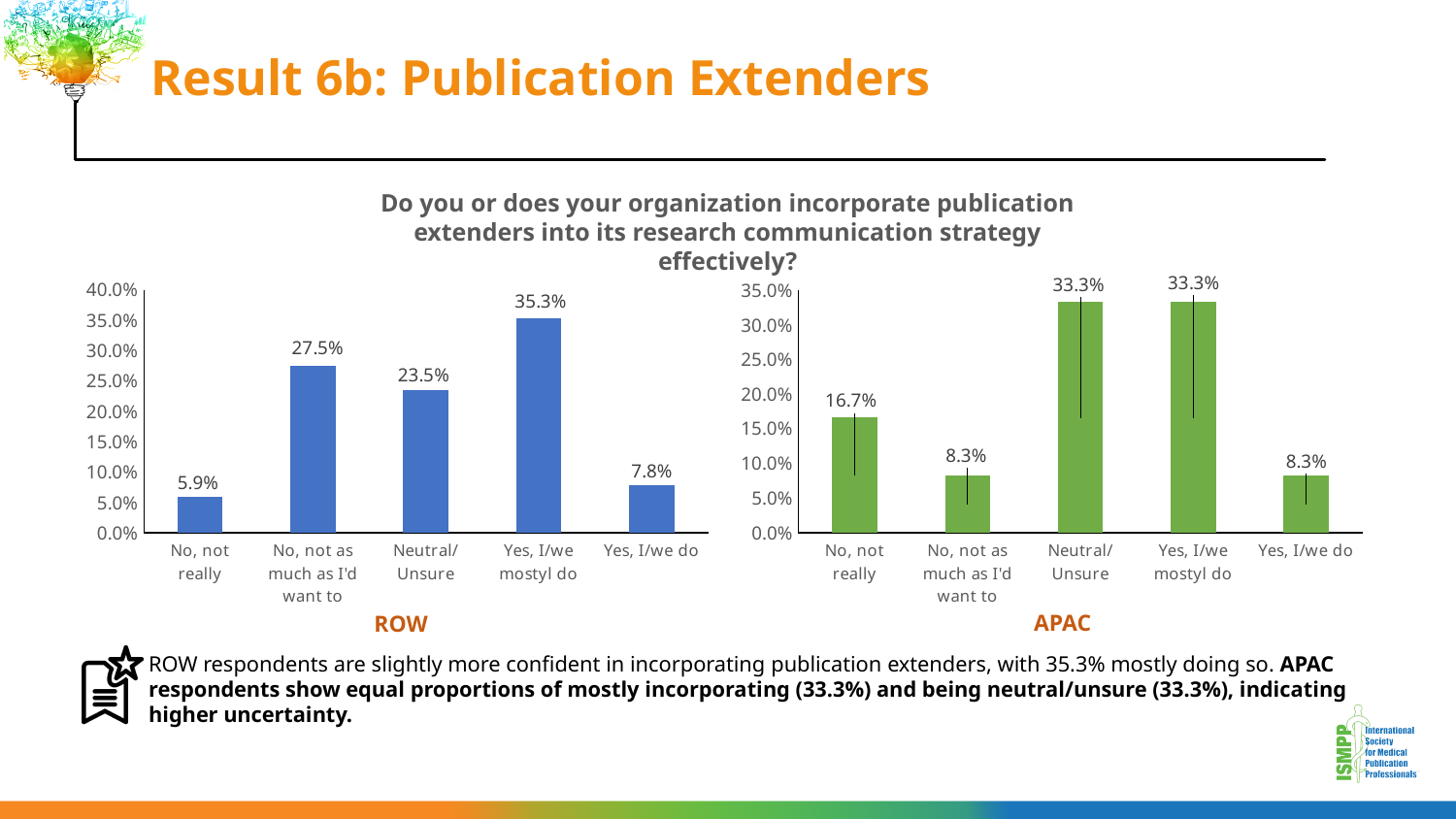
Which is larger: the ROW value for "No, not really" or the APAC value for "No, not really"? APAC (16.7%) In the ROW chart, what is the value for "Yes, I/we mostyl do"? 35.3% In the APAC chart, which category has the lowest value? No, not as much as I'd want to and Yes, I/we do (both 8.3%) In the ROW chart, which category has the lowest value? No, not really What type of chart is the ROW chart? Bar chart How many categories are shown on the x axis of the APAC chart? 5 In the APAC chart, what is the value for "No, not really"? 16.7% In the ROW chart, what is the value for "No, not as much as I'd want to"? 27.5% In the ROW chart, what is the difference between "Yes, I/we mostyl do" and "Neutral/Unsure"? 11.8% In the ROW chart, which category has the highest value? Yes, I/we mostyl do What colour are the bars in the APAC chart? Green In the APAC chart, what is the difference between "Neutral/Unsure" and "No, not really"? 16.6%